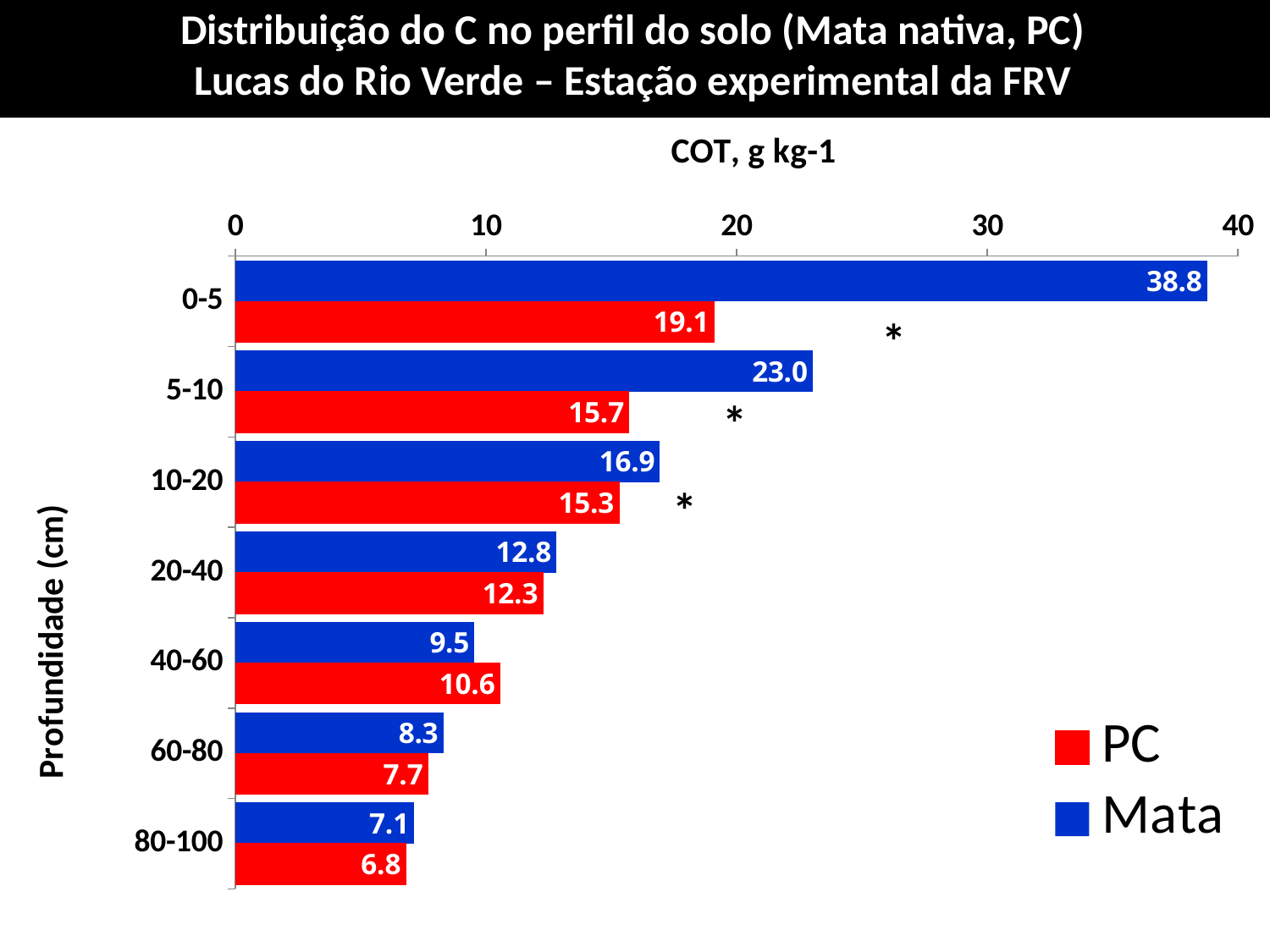
What kind of chart is shown on the slide? bar chart At which depth is the PC value lowest? 80-100 At which depth is the Mata value highest? 0-5 How many depth categories are shown on the chart? 7 What is the COT value for PC at the 5-10 cm depth? 15.7 What colour represents the Mata series? blue What is the COT value for Mata at the 0-5 cm depth? 38.8 What is the difference between the Mata and PC values at the 0-5 cm depth? 19.7 Is the Mata value at 5-10 cm greater or less than 20? greater What is the COT value for PC at the 40-60 cm depth? 10.6 How many series does the legend list? 2 Which is larger at the 40-60 cm depth, PC or Mata? PC